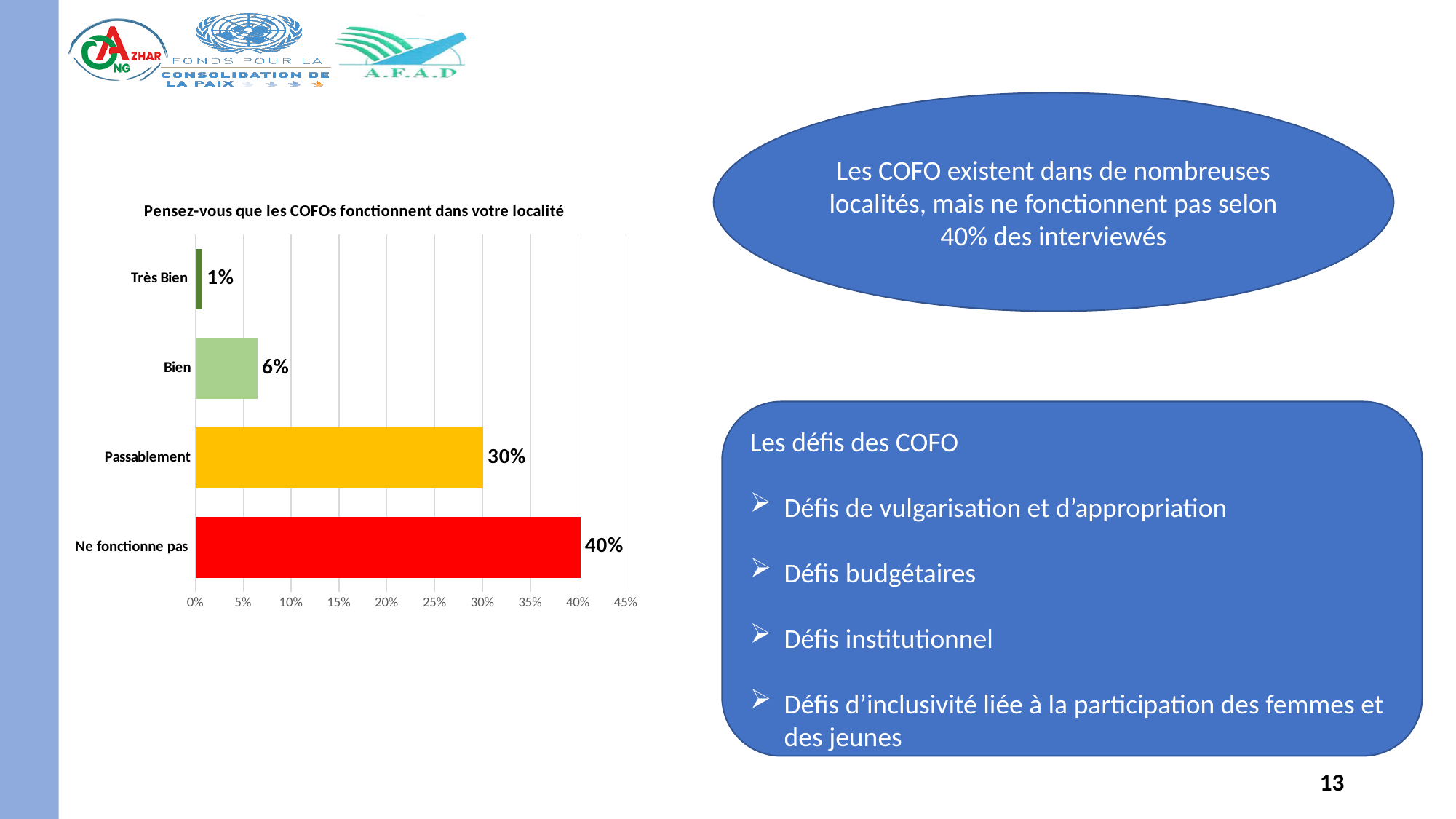
What is the value for "Passablement"? 30% What is the value for "Bien"? 6% What is the difference between the values for "Ne fonctionne pas" and "Passablement"? 10% What is the title of the chart? Pensez-vous que les COFOs fonctionnent dans votre localité How many categories are shown in the chart? 4 Is the value for "Passablement" greater or less than 25%? greater Which category has the lowest value? Très Bien What kind of chart is shown on the slide? Bar chart Which is larger, the value for "Bien" or the value for "Très Bien"? Bien Which category has the highest value? Ne fonctionne pas What is the value for "Très Bien"? 1% What is the value for "Ne fonctionne pas"? 40%